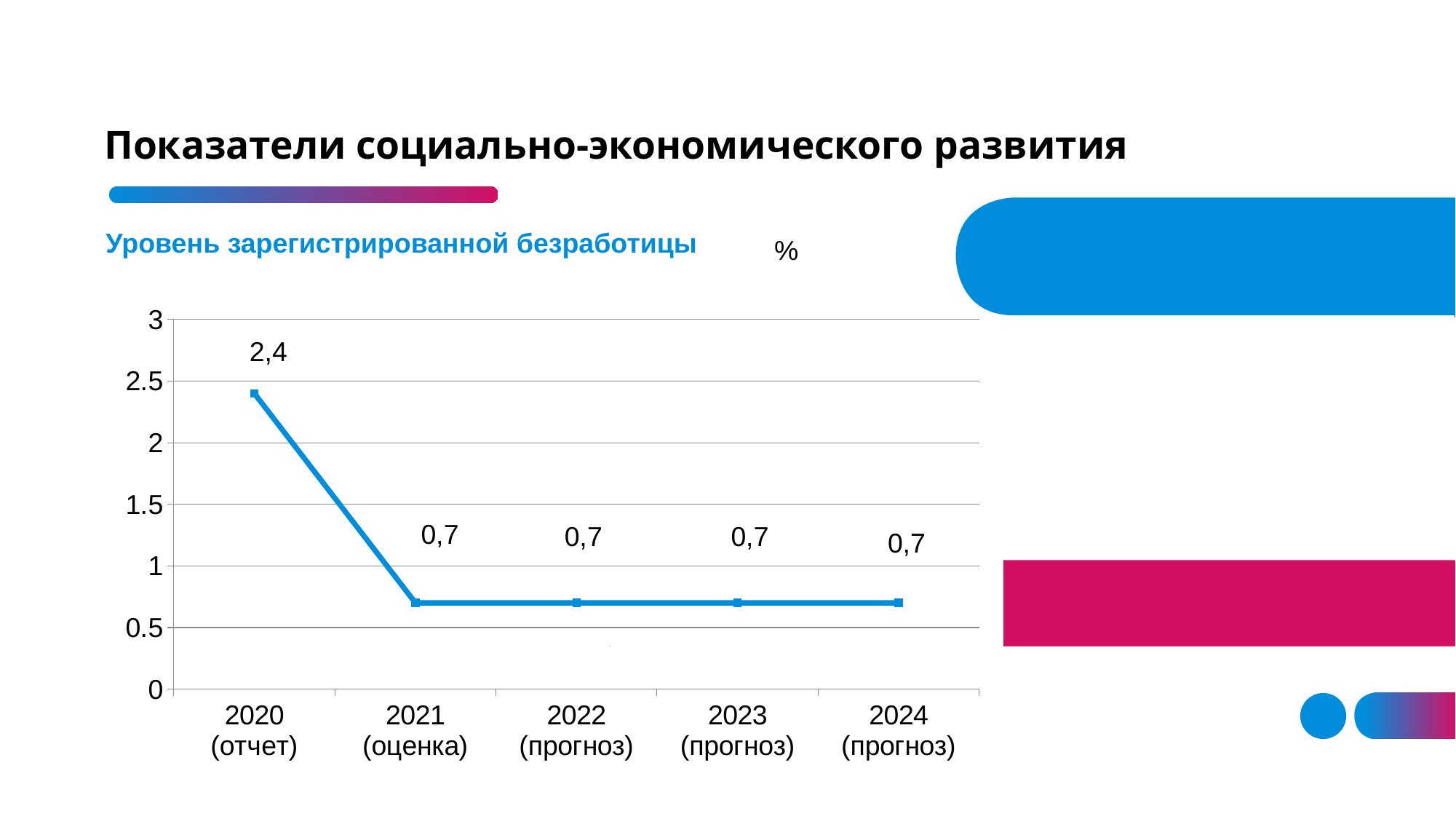
Which is larger, the value for 2020 (отчет) or the value for 2023 (прогноз)? 2020 (отчет) Do the values rise or fall from 2020 to 2021? fall What is the value for 2022 (прогноз)? 0,7 What is the value for 2024 (прогноз)? 0,7 What kind of chart is this? line chart How many years are shown on the x axis? 5 What is the difference between the values for 2020 (отчет) and 2021 (оценка)? 1,7 What is the title of the chart? Уровень зарегистрированной безработицы Is the value for 2020 (отчет) greater or less than 2? greater Is the value for 2023 (прогноз) greater or less than 1? less Which year has the highest value? 2020 (отчет) What is the value for 2020 (отчет)? 2,4